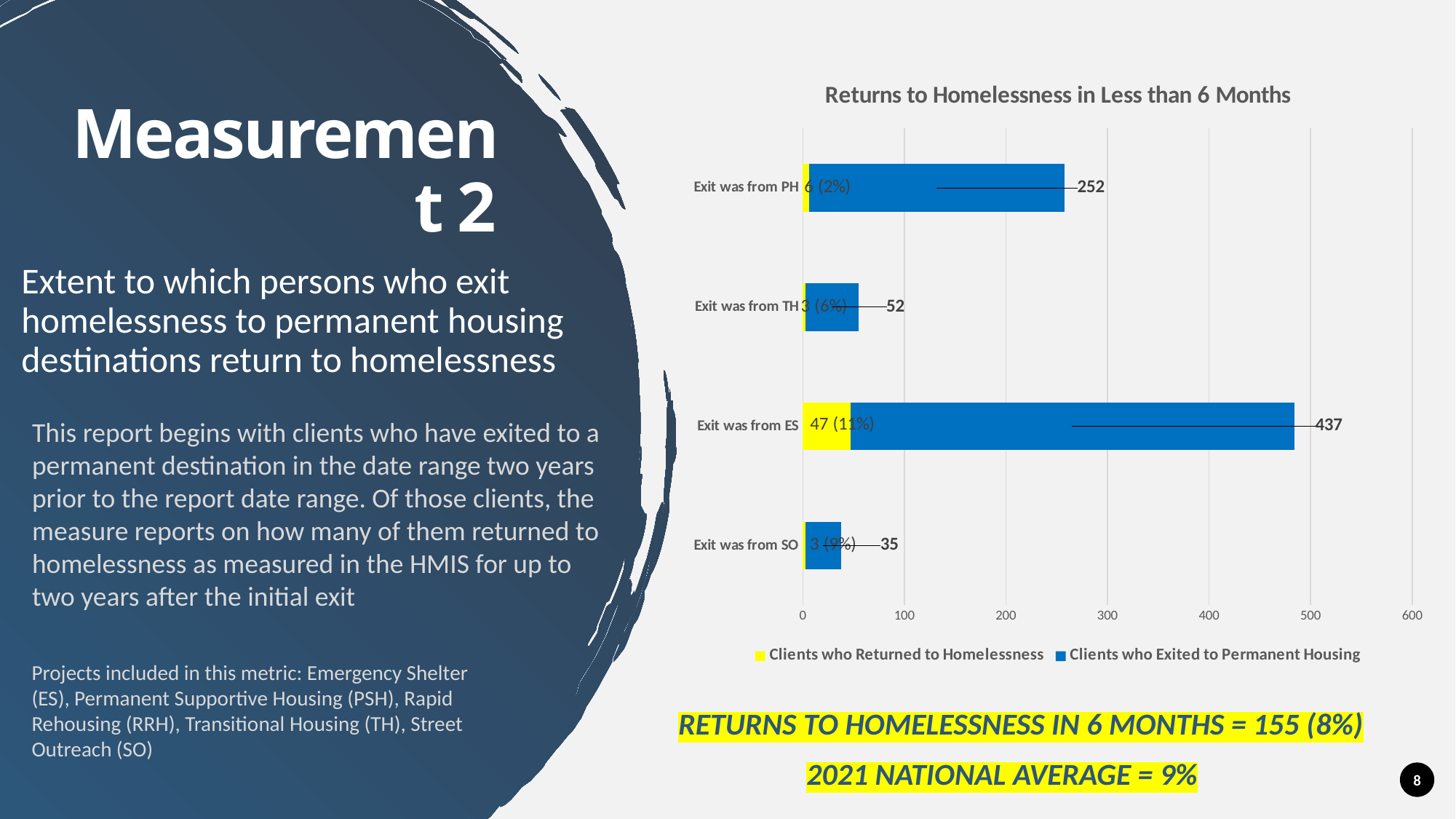
Which exit category has the highest number of clients who exited to permanent housing? Exit was from ES How many clients who exited from SO exited to permanent housing? 35 What is the difference between the number of clients who exited to permanent housing from PH and from TH? 200 How many exit categories are plotted in the chart? 4 Which is larger: the number of clients who returned to homelessness from ES or from PH? Exit was from ES What is the title of the chart? Returns to Homelessness in Less than 6 Months Which series is shown in yellow in the chart? Clients who Returned to Homelessness Which exit category has the lowest number of clients who exited to permanent housing? Exit was from SO How many clients who exited from ES exited to permanent housing? 437 How many series does the chart legend list? 2 What is the data label for clients who returned to homelessness after exiting from PH? 6 (2%) What type of chart is shown on the slide? bar chart